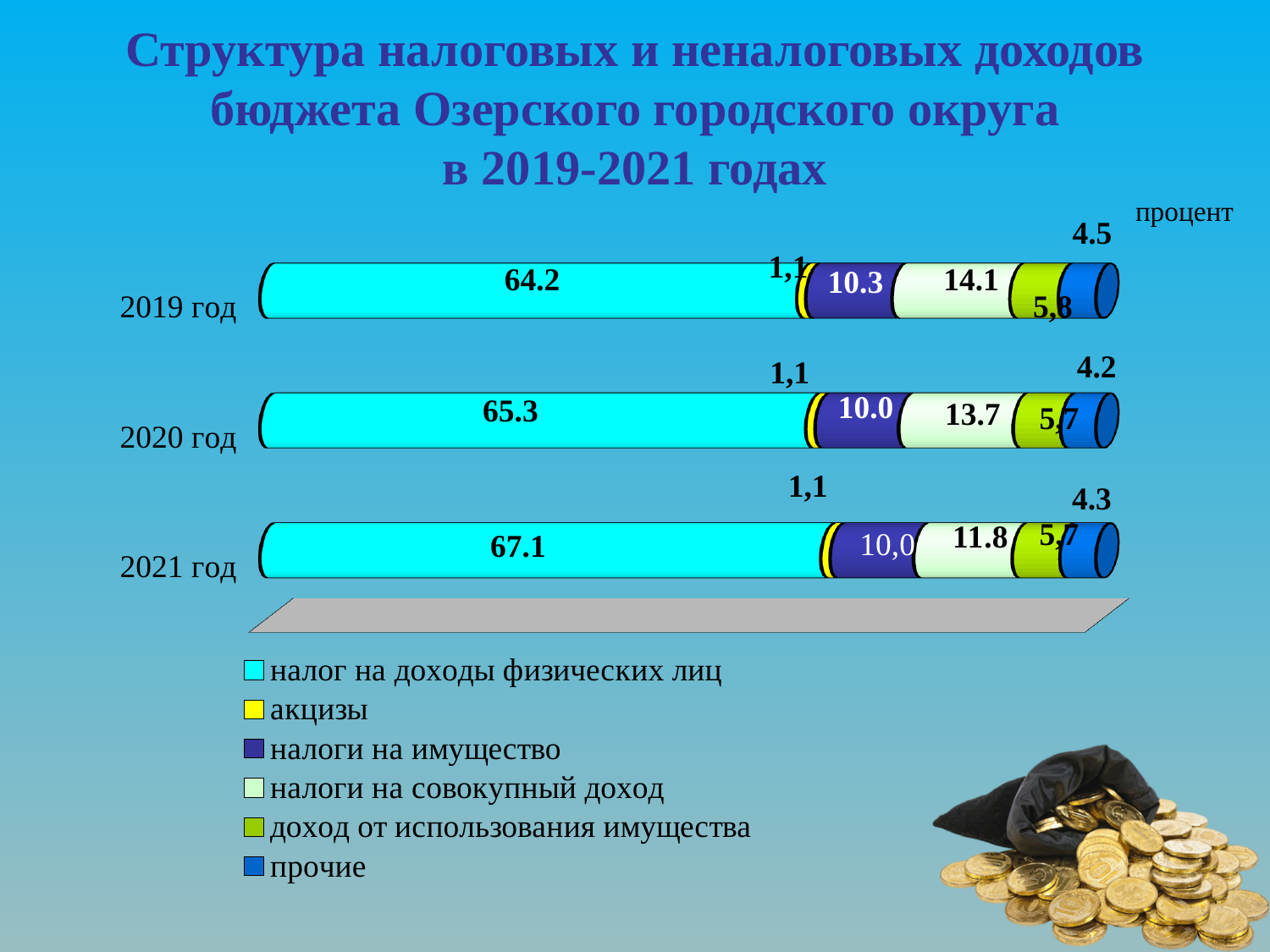
How many series does the legend list? 6 Which year has the lowest value for налоги на совокупный доход? 2021 год What is the difference between the налог на доходы физических лиц values for 2021 год and 2019 год? 2.9 How many years (bars) are shown in the chart? 3 Does the value for налог на доходы физических лиц rise or fall from 2019 год to 2021 год? rise What kind of chart is shown on the slide? stacked bar chart What is the value for налог на доходы физических лиц in 2019 год? 64.2 What is the value for налоги на имущество in 2020 год? 10.0 Which is larger: налоги на совокупный доход in 2019 год or in 2020 год? 2019 год Which year has the highest value for налог на доходы физических лиц? 2021 год What is the value for прочие in 2019 год? 4.5 What is the value for налоги на совокупный доход in 2021 год? 11.8